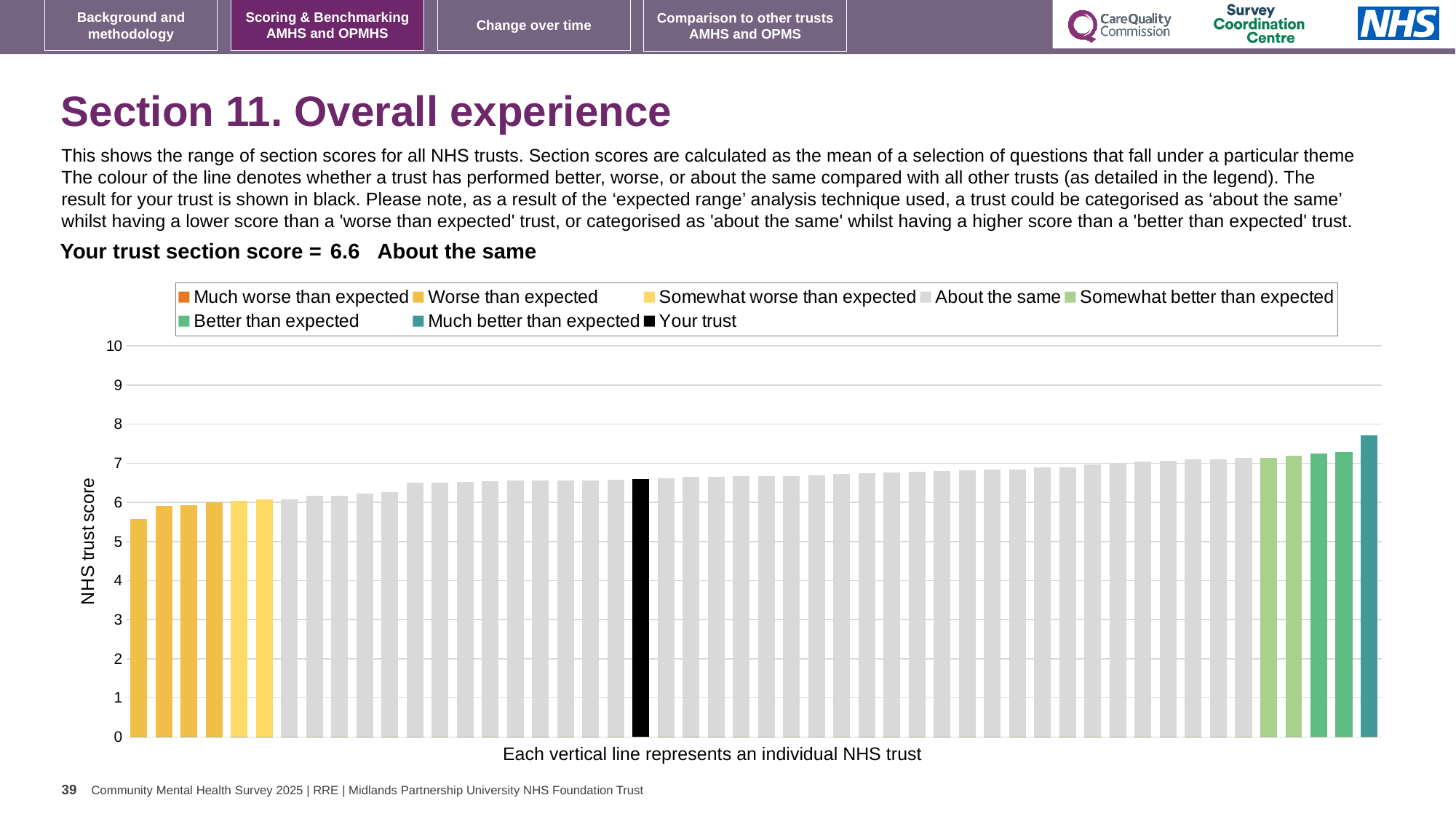
Is your trust's score higher or lower than the highest-scoring trust? lower What kind of chart is shown on the slide? bar chart Is the value of the highest bar greater or less than 8? less How many entries does the chart legend list? 8 What is the section score for your trust shown on the slide? 6.6 Is the value of the lowest bar greater or less than 6? less Which legend category is your trust placed in? About the same Is the value of the highest bar greater or less than 7? greater Which legend category does the highest-scoring trust belong to? Much better than expected Do the bar values rise or fall from left to right along the x axis? rise What is the label on the vertical axis of the chart? NHS trust score